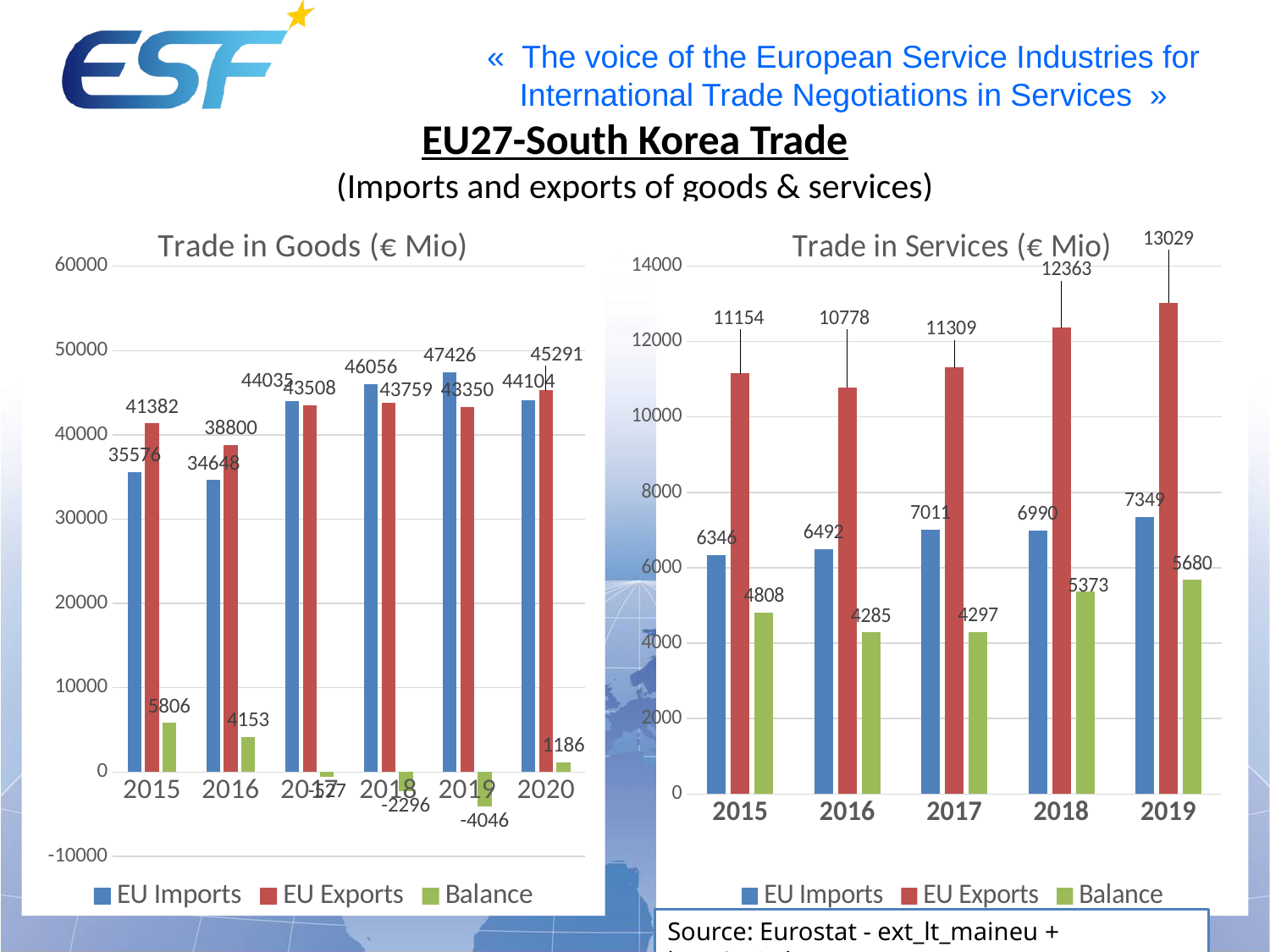
In the Trade in Services chart, do EU Exports rise or fall from 2017 to 2019? Rise In the Trade in Goods chart, what is the value of EU Exports in 2015? 41382 In the Trade in Services chart, what is the value of EU Exports in 2019? 13029 How many years are shown on the x axis of the Trade in Goods chart? 6 How many series does the legend of the Trade in Services chart list? 3 What kind of chart is the Trade in Services chart? Bar chart In the Trade in Goods chart, which year has the lowest EU Imports value? 2016 In the Trade in Services chart, what is the difference between EU Exports in 2019 and EU Exports in 2015? 1875 In the Trade in Goods chart, what is the Balance value for 2019? -4046 In the Trade in Goods chart, which is larger in 2019: EU Imports or EU Exports? EU Imports In the Trade in Services chart, which year has the highest EU Exports value? 2019 In the Trade in Goods chart, is the value for EU Imports in 2018 greater or less than 40000? greater